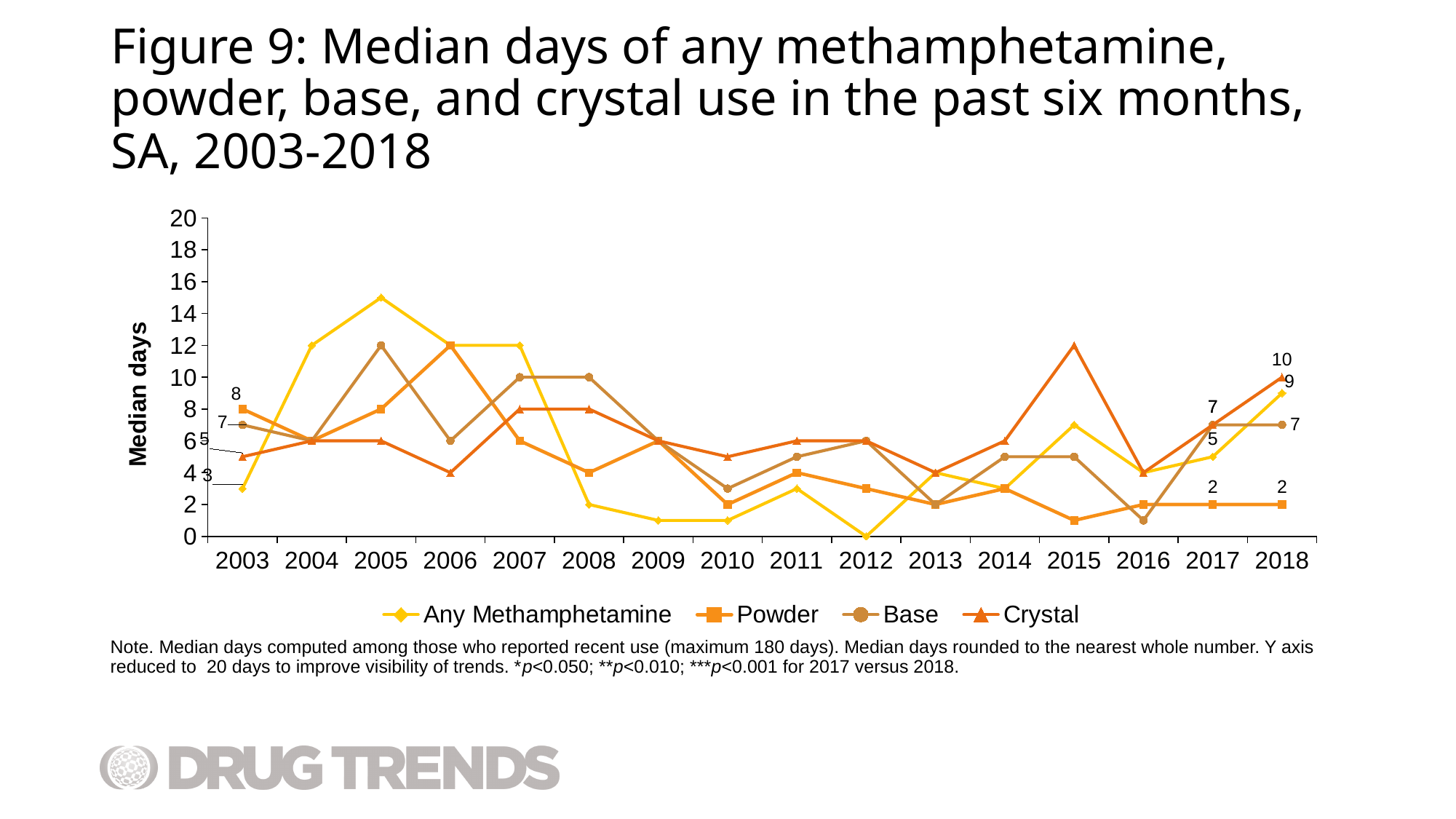
What is the median days value for Crystal in 2018? 10 How many years are shown along the x axis? 16 What is the median days value for Base in 2018? 7 What is the median days value for Any Methamphetamine in 2018? 9 What kind of chart is shown on the slide? line chart What is the difference between the Crystal and Powder values in 2018? 8 What is the median days value for Powder in 2003? 8 How many series does the legend list? 4 Which series has the lowest value in 2018? Powder In 2003, which is larger: the Powder value or the Base value? Powder Is the value for Any Methamphetamine in 2005 greater or less than 10? greater Which series has the highest value in 2018? Crystal